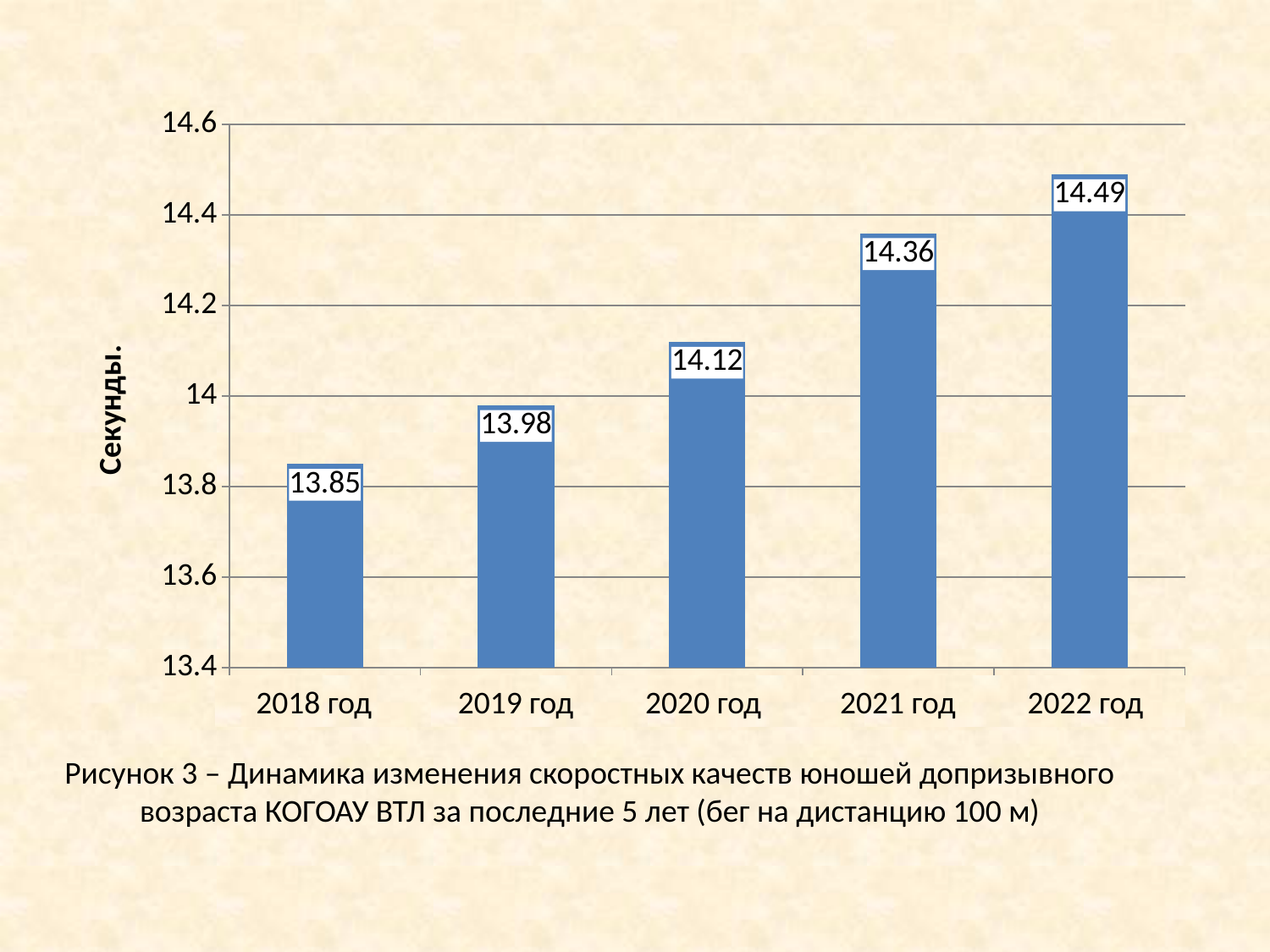
What is the value for 2022 год? 14.49 What is the value for 2018 год? 13.85 What is the value for 2020 год? 14.12 Which year has the highest value? 2022 год Is the value for 2019 год greater or less than 14? less Do the values rise or fall from 2018 год to 2022 год? rise Which year has the lowest value? 2018 год What is the difference between the values for 2022 год and 2018 год? 0.64 What kind of chart is shown on the slide? bar chart Which is larger, the value for 2019 год or the value for 2021 год? 2021 год How many years are shown on the x axis? 5 What is the difference between the values for 2021 год and 2020 год? 0.24